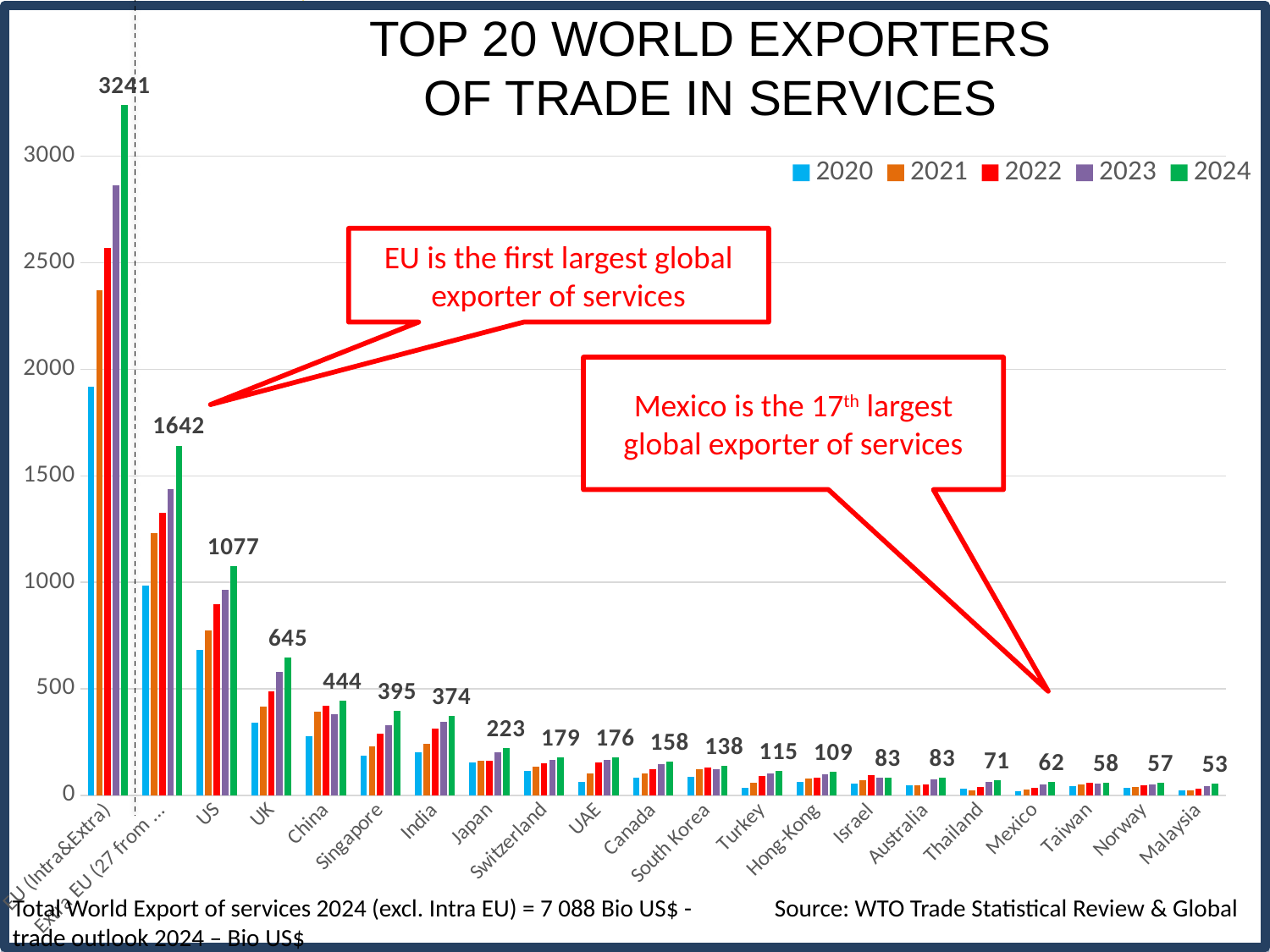
Which category has the lowest 2024 value? Malaysia Is the 2020 value for the US greater or less than 500? greater How many series does the legend list? 5 What is the title of the chart? TOP 20 WORLD EXPORTERS OF TRADE IN SERVICES What is the 2024 value for the US? 1077 Do the 2024 values rise or fall moving from left to right along the x axis? Fall What kind of chart is shown on the slide? Bar chart Which has the larger 2024 value, Japan or Switzerland? Japan What is the 2024 value for Mexico? 62 What is the difference between the 2024 values for the UK and China? 201 Which category has the highest 2024 value? EU (Intra&Extra) What is the 2024 value for Singapore? 395